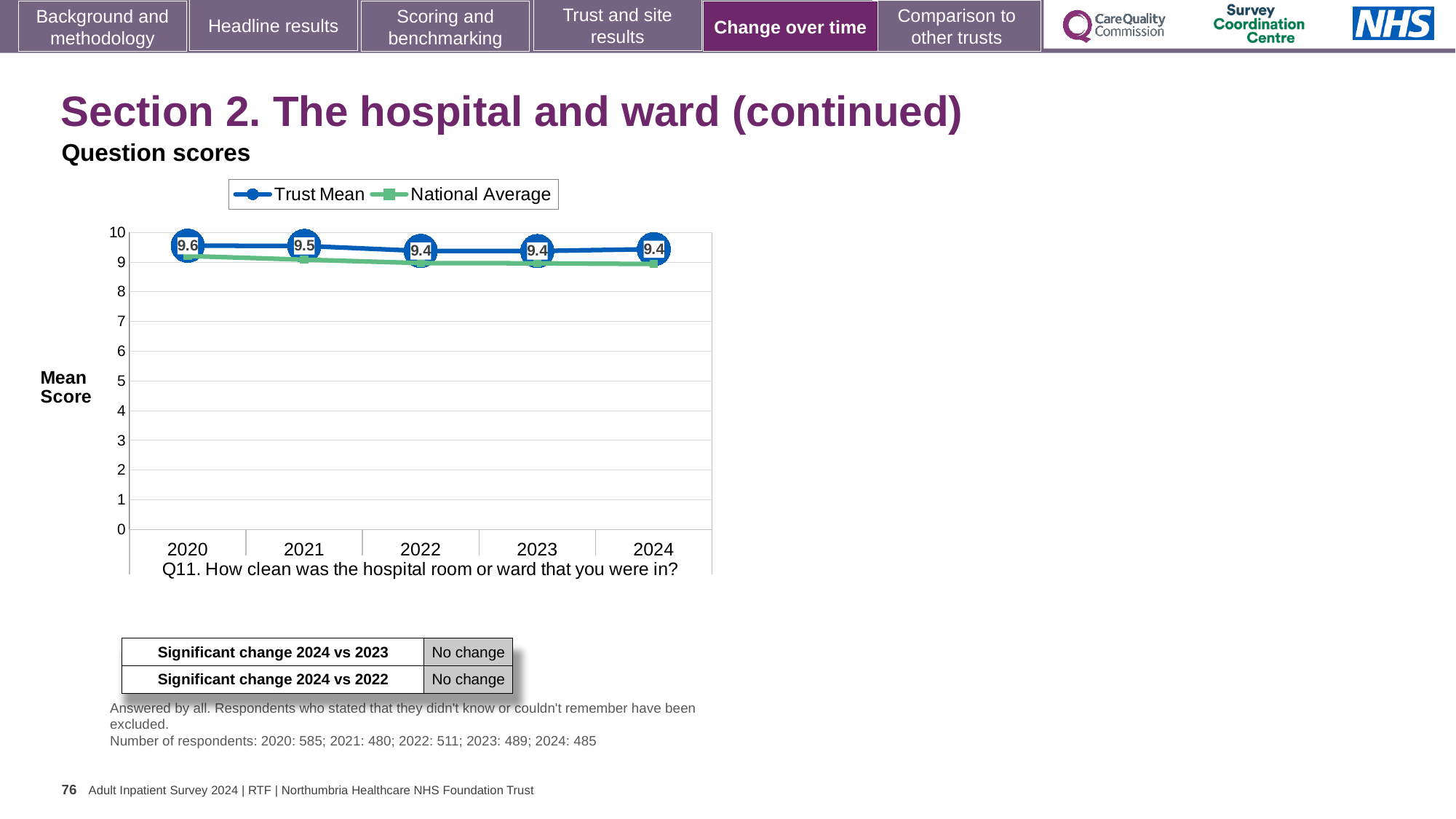
How many years are shown on the x axis? 5 What is the difference between the Trust Mean in 2020 and in 2024? 0.2 What is the Trust Mean value for 2020? 9.6 Which is larger, the Trust Mean for 2020 or for 2022? 2020 What is the Trust Mean value for 2021? 9.5 Is the National Average value for 2020 greater or less than 5? greater What is the Trust Mean value for 2024? 9.4 In which year is the Trust Mean highest? 2020 How many series does the legend list? 2 What are the two series named in the legend? Trust Mean and National Average Does the Trust Mean rise or fall from 2020 to 2024? fall What kind of chart is shown on the slide? line chart